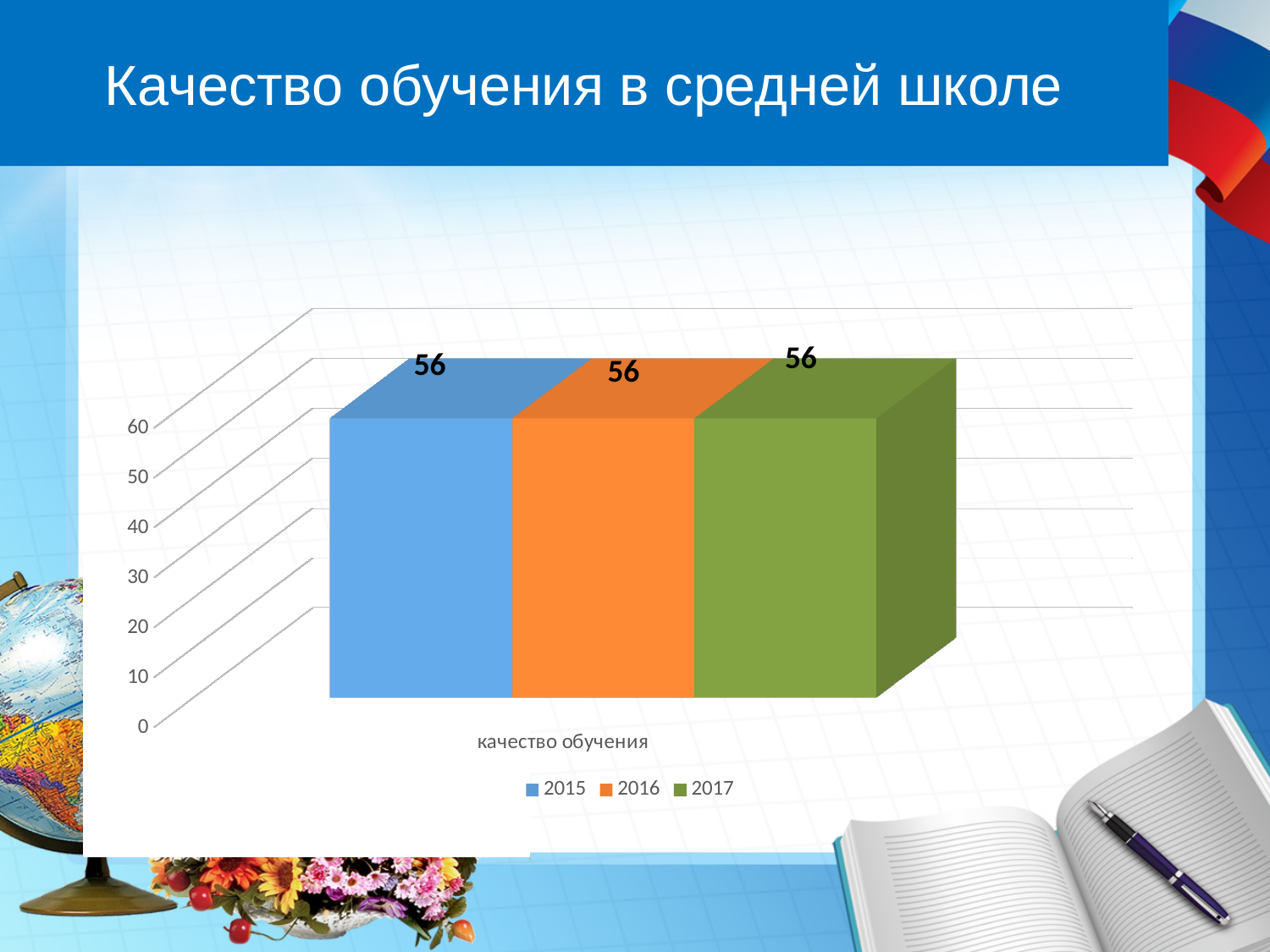
Is the value for 2015 greater or less than 50? greater What is the value for 2017 in the chart? 56 How many series does the legend list? 3 What is the value for 2015 in the chart? 56 What kind of chart is shown on the slide? bar chart Which colour represents the 2016 series in the legend? orange What is the label of the category on the x axis? качество обучения What is the value for 2016 in the chart? 56 Do the values rise, fall or stay the same from 2015 to 2017? stay the same Is the value for 2017 greater or less than 60? less How many categories are shown on the x axis of the chart? 1 What is the difference between the values for 2016 and 2015? 0